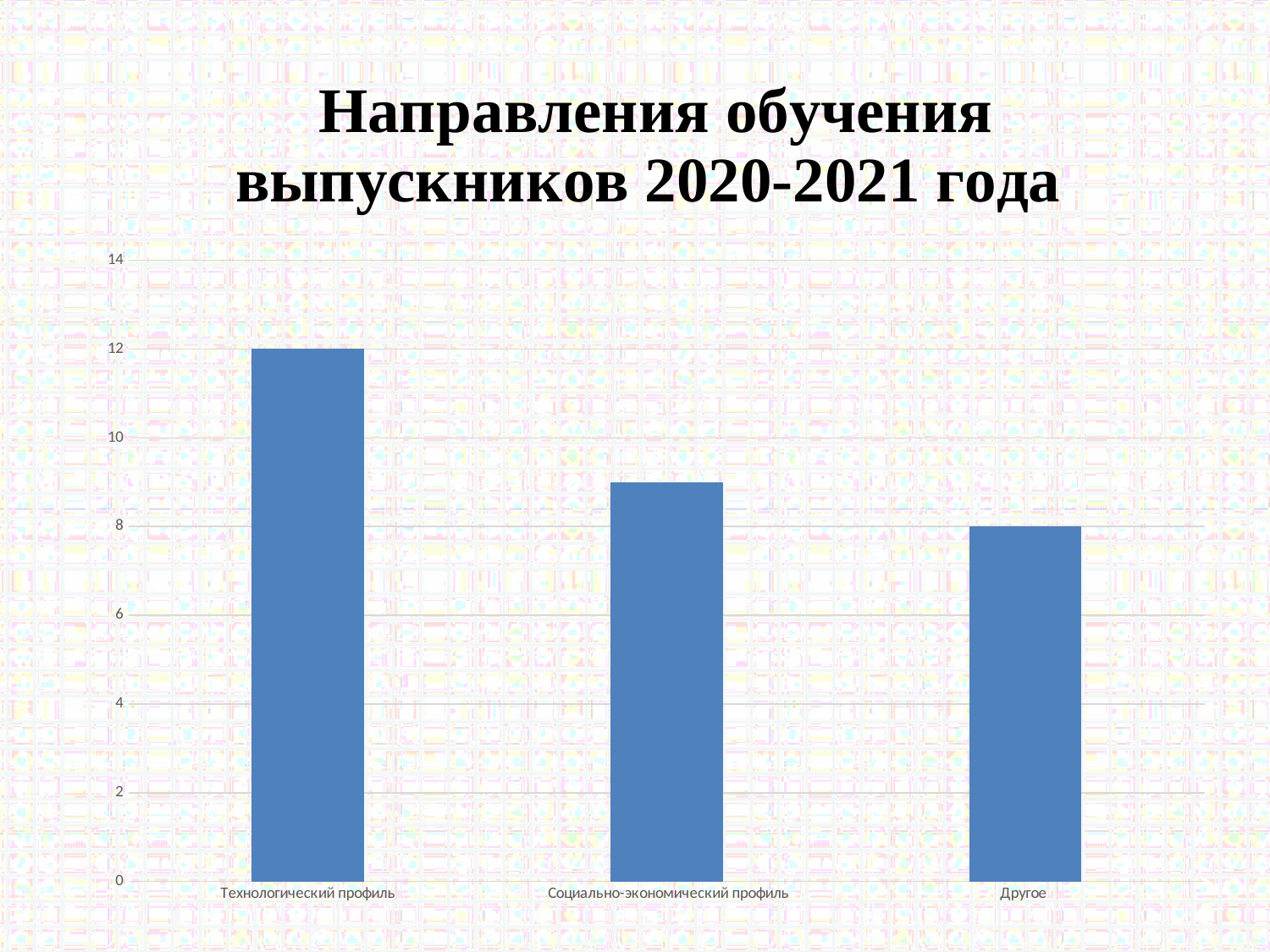
What is the difference between the values for Технологический профиль and Другое? 4 What is the value for Другое? 8 Which category has the lowest value? Другое What is the title of the chart on the slide? Направления обучения выпускников 2020-2021 года Which is larger, the value for Технологический профиль or the value for Социально-экономический профиль? Технологический профиль Is the value for Социально-экономический профиль greater or less than 10? less What kind of chart is shown on the slide? bar chart How many categories are shown on the x axis of the chart? 3 Which category has the highest value? Технологический профиль Is the value for Социально-экономический профиль greater or less than 8? greater Do the values rise or fall from left to right along the x axis? fall What is the value for Технологический профиль? 12